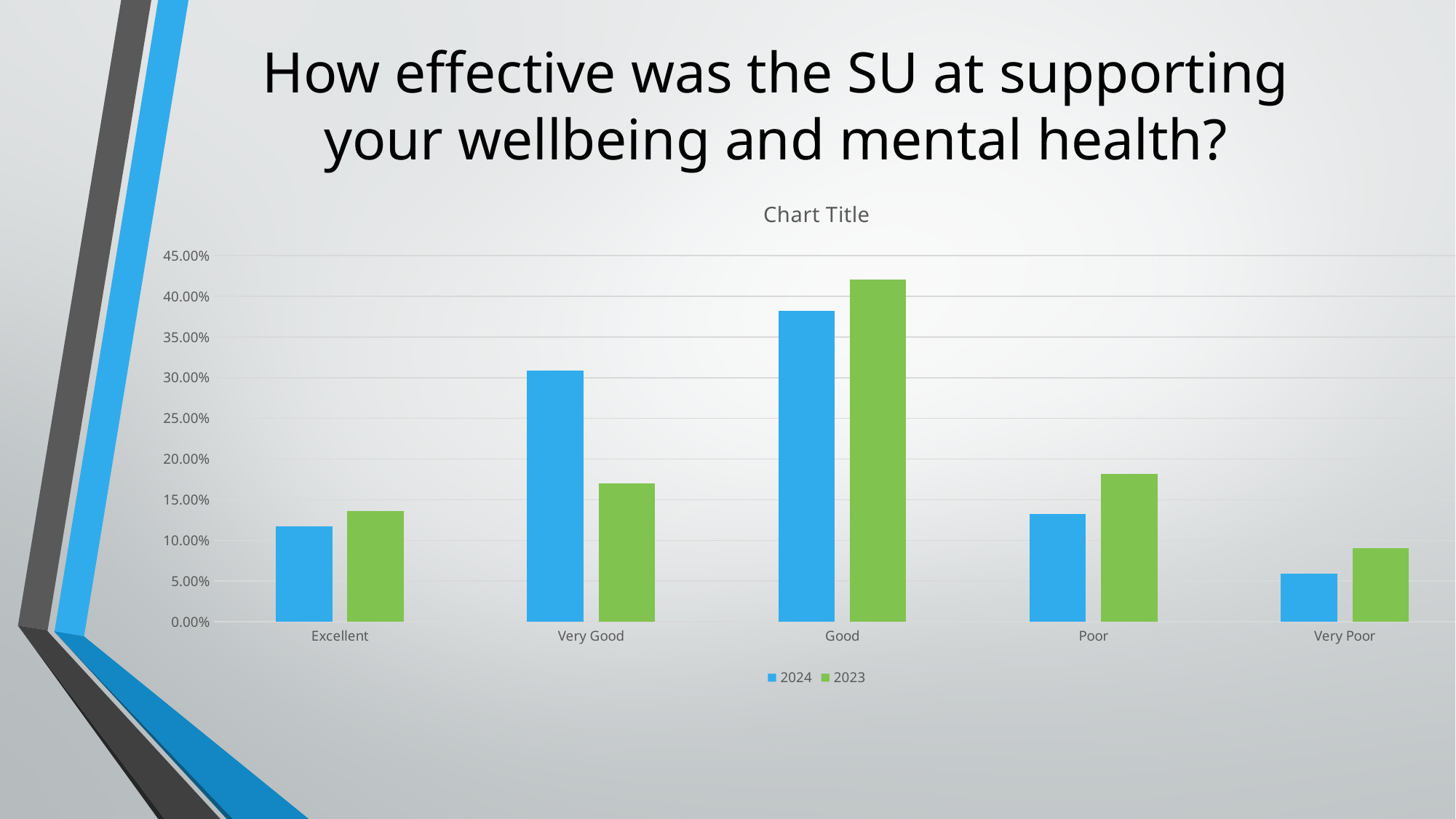
For the Poor category, which series has the larger value, 2024 or 2023? 2023 How many categories are shown on the x axis of the chart? 5 What kind of chart is shown on the slide? bar chart Which category has the highest value for the 2024 series? Good For the Very Good category, which series has the larger value, 2024 or 2023? 2024 Is the 2023 value for Good greater or less than 40.00%? greater How many series does the chart's legend list? 2 Which category has the highest value for the 2023 series? Good Is the 2024 value for Very Poor greater or less than 10.00%? less What are the two entries listed in the chart's legend? 2024 and 2023 Is the 2024 value for Very Good greater or less than 25.00%? greater Which category has the lowest value for the 2024 series? Very Poor